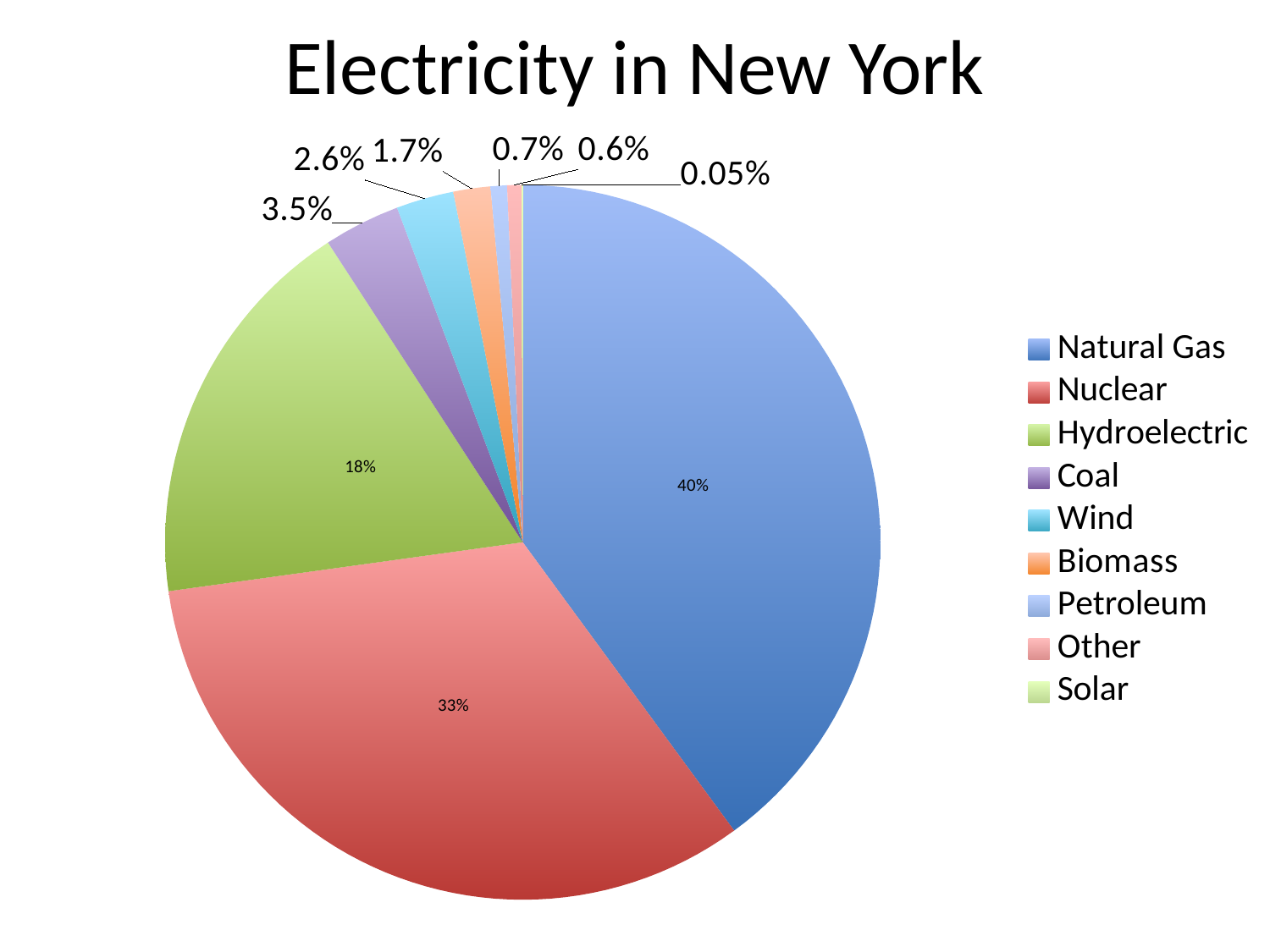
Which source has the largest share of electricity in New York? Natural Gas What is the title of the chart? Electricity in New York What type of chart is shown on the slide? pie chart What share of electricity in New York comes from Solar? 0.05% What share of electricity in New York comes from Hydroelectric? 18% Which source has the smallest share of electricity in New York? Solar What share of electricity in New York comes from Nuclear? 33% What share of electricity in New York comes from Coal? 3.5% What share of electricity in New York comes from Natural Gas? 40% What share of electricity in New York comes from Wind? 2.6% What is the difference between the Natural Gas share and the Nuclear share? 7% How many categories does the legend list? 9